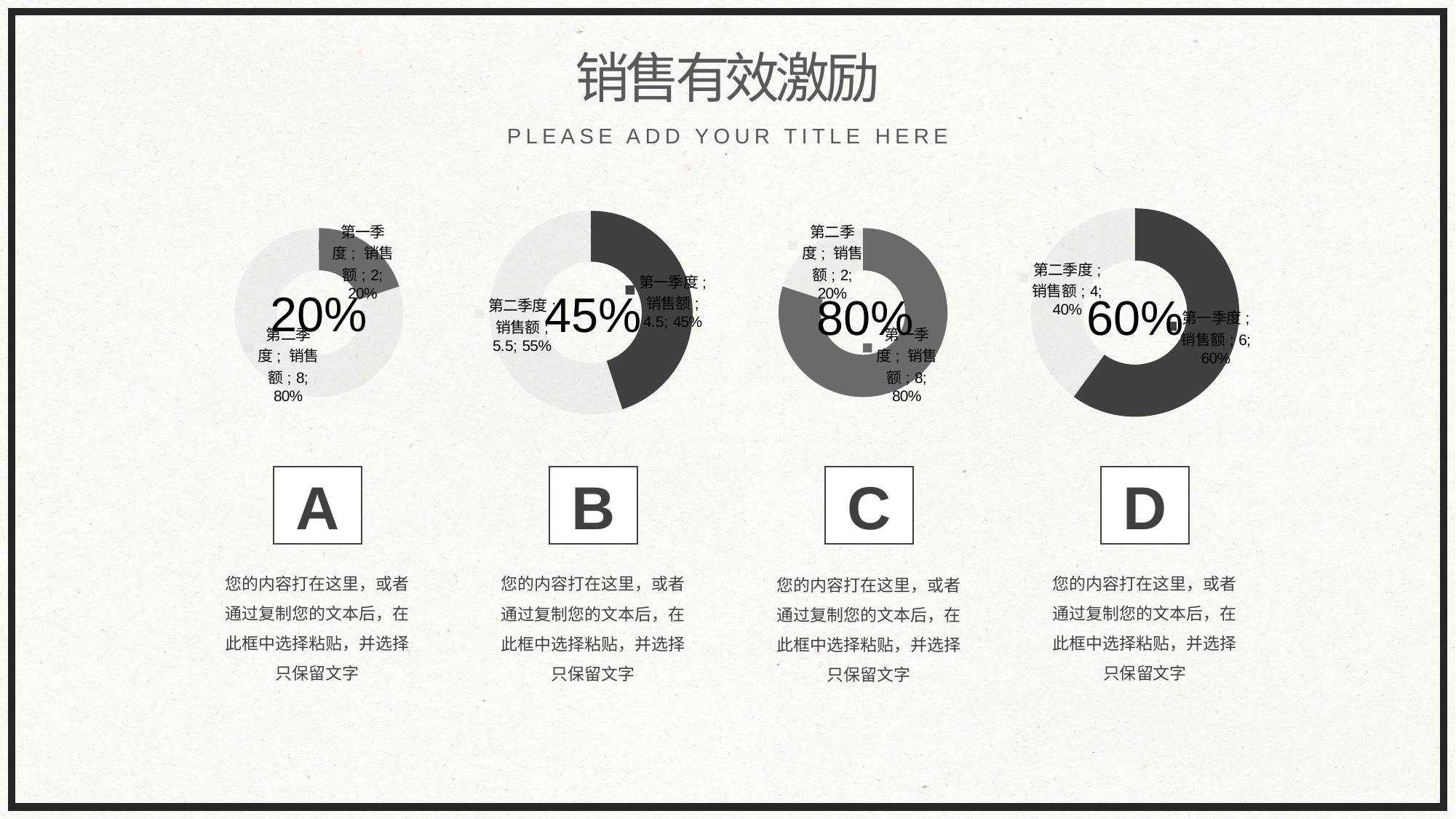
In the donut chart above the letter A, what percentage share does 第二季度 have? 80% In the donut chart above the letter D, what is the 销售额 value for 第二季度? 4 What kind of chart is shown above the letter C? Donut (pie) chart In the donut chart above the letter A, what is the 销售额 value for 第一季度? 2 In the donut chart above the letter C, what is the 销售额 value for 第一季度? 8 In the donut chart above the letter B, what percentage share does 第一季度 have? 45% In the donut chart above the letter C, which category has the larger share, 第一季度 or 第二季度? 第一季度 In the donut chart above the letter B, what is the 销售额 value for 第二季度? 5.5 What is the large percentage printed in the centre of the donut chart above the letter D? 60% In the donut chart above the letter B, what is the total of the two 销售额 values? 10 How many slices does the donut chart above the letter A have? 2 In the donut chart above the letter D, what is the difference between the 销售额 values of 第一季度 and 第二季度? 2